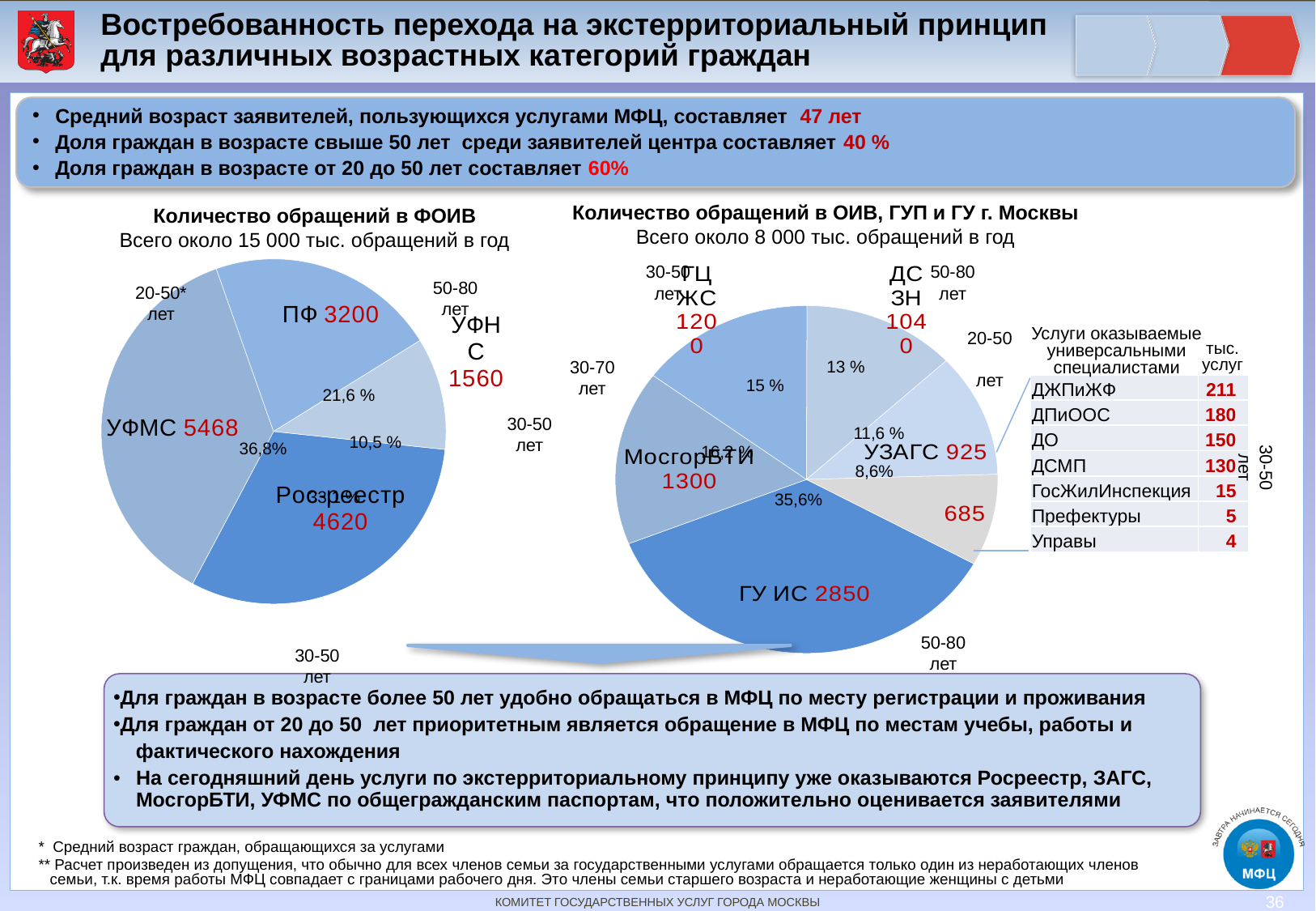
In the left chart "Количество обращений в ФОИВ", which slice is the largest? УФМС In the left chart "Количество обращений в ФОИВ", what is the difference between the values for УФМС and Росреестр? 848 In the left chart "Количество обращений в ФОИВ", what share of the pie does ПФ represent? 21,6 % In the right chart "Количество обращений в ОИВ, ГУП и ГУ г. Москвы", which slice is the largest? ГУ ИС In the right chart "Количество обращений в ОИВ, ГУП и ГУ г. Москвы", what is the value for ГУ ИС? 2850 What kind of chart is the left chart titled "Количество обращений в ФОИВ"? pie chart In the left chart "Количество обращений в ФОИВ", what is the value for УФМС? 5468 In the left chart "Количество обращений в ФОИВ", which slice is the smallest? УФНС In the right chart "Количество обращений в ОИВ, ГУП и ГУ г. Москвы", which is larger, ГЦЖС or ДСЗН? ГЦЖС In the right chart "Количество обращений в ОИВ, ГУП и ГУ г. Москвы", what share of the pie does ГУ ИС represent? 35,6% In the left chart "Количество обращений в ФОИВ", what is the value for Росреестр? 4620 In the right chart "Количество обращений в ОИВ, ГУП и ГУ г. Москвы", what is the difference between the values for ГУ ИС and МосгорБТИ? 1550